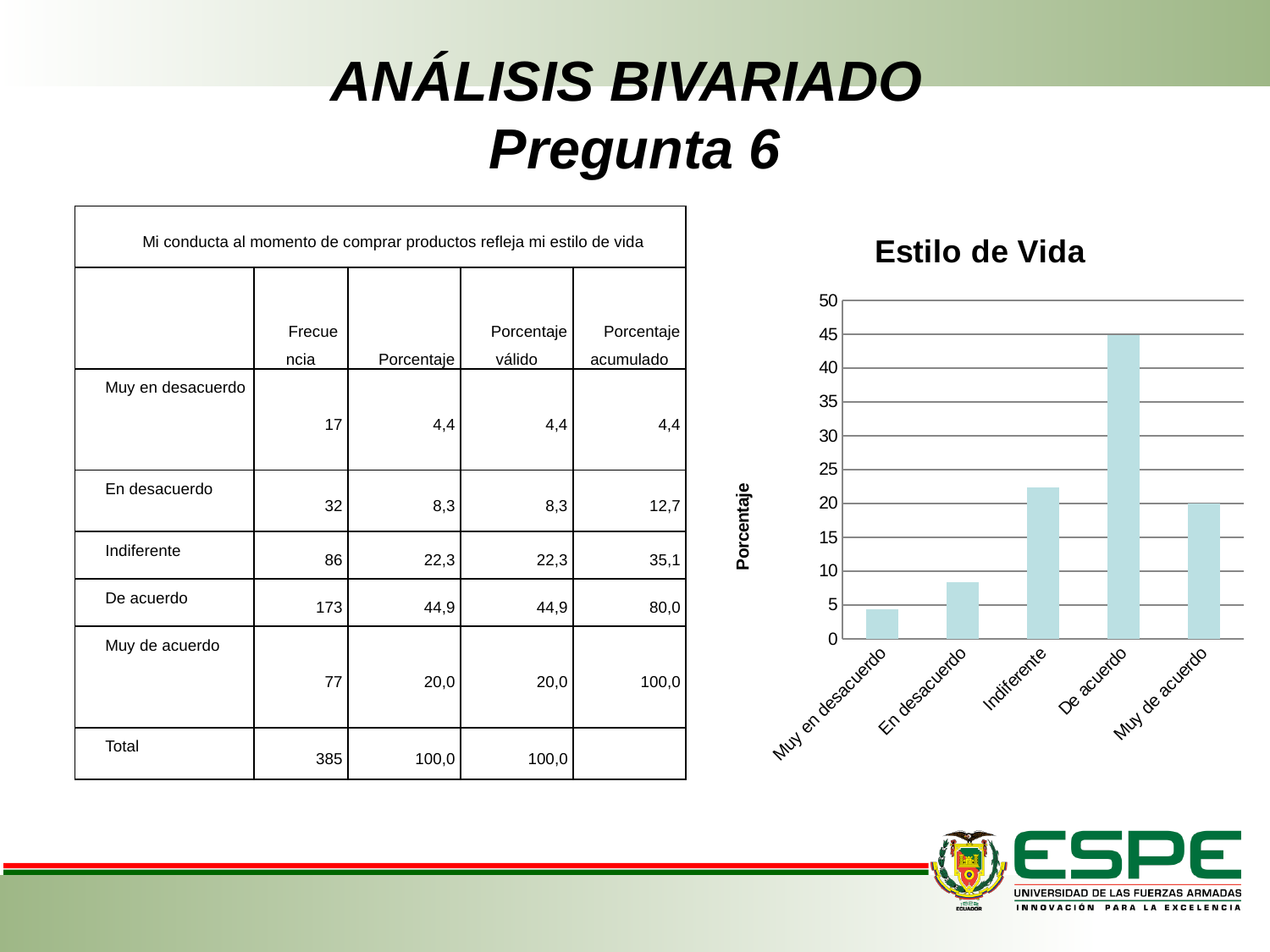
How many categories are shown on the x axis of the chart? 5 Which category has the lowest bar in the chart? Muy en desacuerdo What is the title of the chart? Estilo de Vida According to the table, what percentage (Porcentaje) corresponds to Muy en desacuerdo? 4,4 Is the value for En desacuerdo greater or less than 10? less Which category has the highest bar in the chart? De acuerdo According to the table, what percentage (Porcentaje) corresponds to De acuerdo? 44,9 What type of chart is shown on the slide? bar chart Is the value for De acuerdo greater or less than 40? greater What is the label of the vertical axis of the chart? Porcentaje Is the value for Indiferente greater or less than 25? less Which is larger in the chart, the bar for Indiferente or the bar for Muy de acuerdo? Indiferente